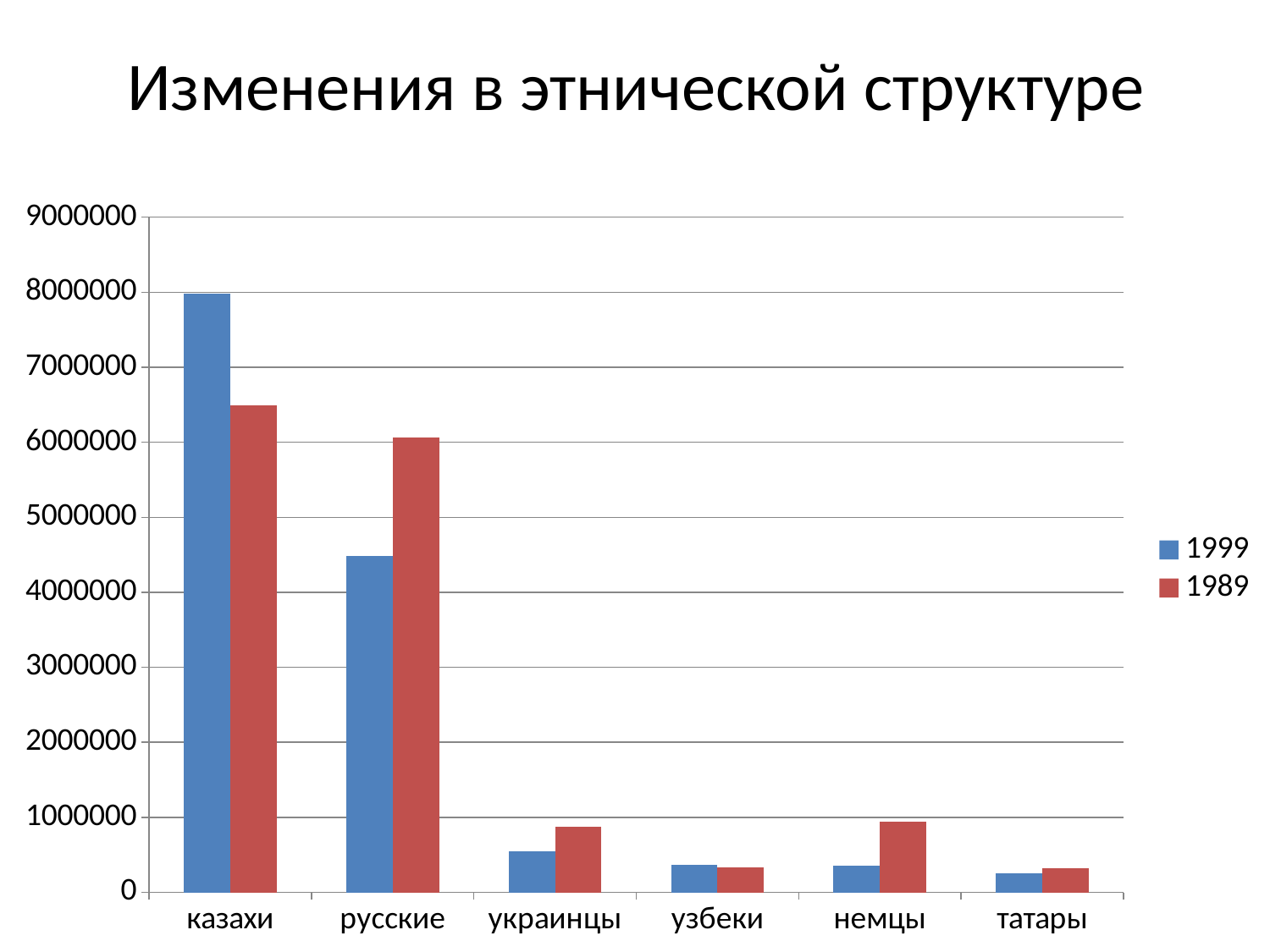
For казахи, which series has the larger value, 1999 or 1989? 1999 Is the 1999 value for казахи greater or less than 7000000? greater Which category has the highest value for the 1989 series? казахи How many series does the legend list? 2 How many ethnic groups (categories) are shown on the x axis? 6 Which category has the highest value for the 1999 series? казахи Which category has the lowest value for the 1999 series? татары For русские, which series has the larger value, 1999 or 1989? 1989 What is the title of the chart on the slide? Изменения в этнической структуре Is the 1999 value for русские greater or less than 5000000? less What kind of chart is shown on the slide? bar chart